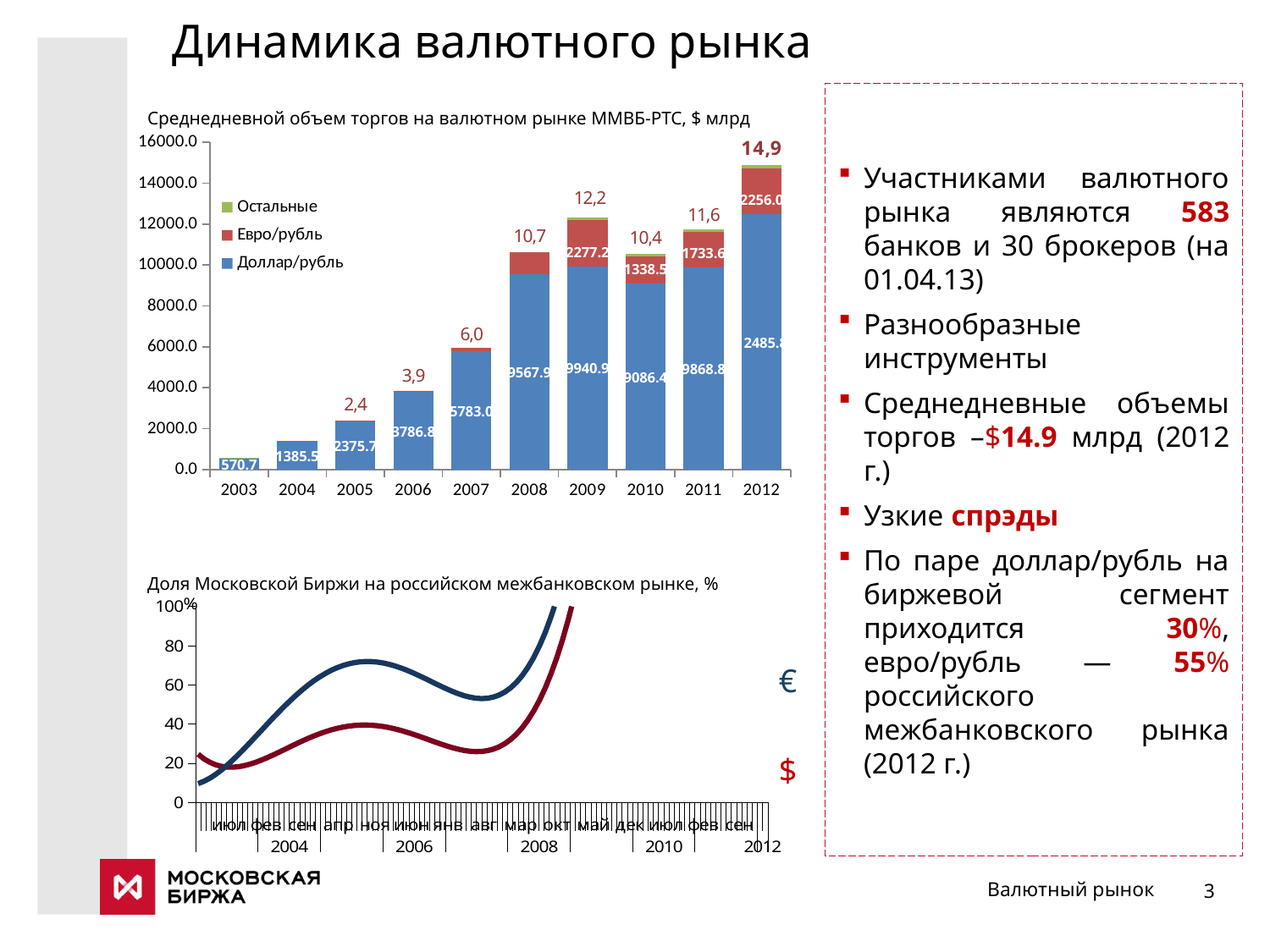
In the top chart, does the Доллар/рубль value rise or fall from 2003 to 2008? rise In the top chart, how many years are shown on the x axis? 10 In the top chart, what is the difference between the Доллар/рубль values for 2004 and 2003? 814.8 In the top chart, which year has the lowest Доллар/рубль value? 2003 In the top chart, what is the value of Доллар/рубль for 2003? 570.7 In the top chart, how many series does the legend list? 3 In the top chart, which year has the highest total bar? 2012 What kind of chart is the bottom chart, 'Доля Московской Биржи на российском межбанковском рынке, %'? line chart What kind of chart is the top chart, 'Среднедневной объем торгов на валютном рынке ММВБ-РТС, $ млрд'? bar chart In the top chart, which year has the larger Евро/рубль value, 2009 or 2010? 2009 In the top chart, what is the value of Евро/рубль for 2011? 1733.6 In the top chart, what total is printed above the bar for 2012? 14,9